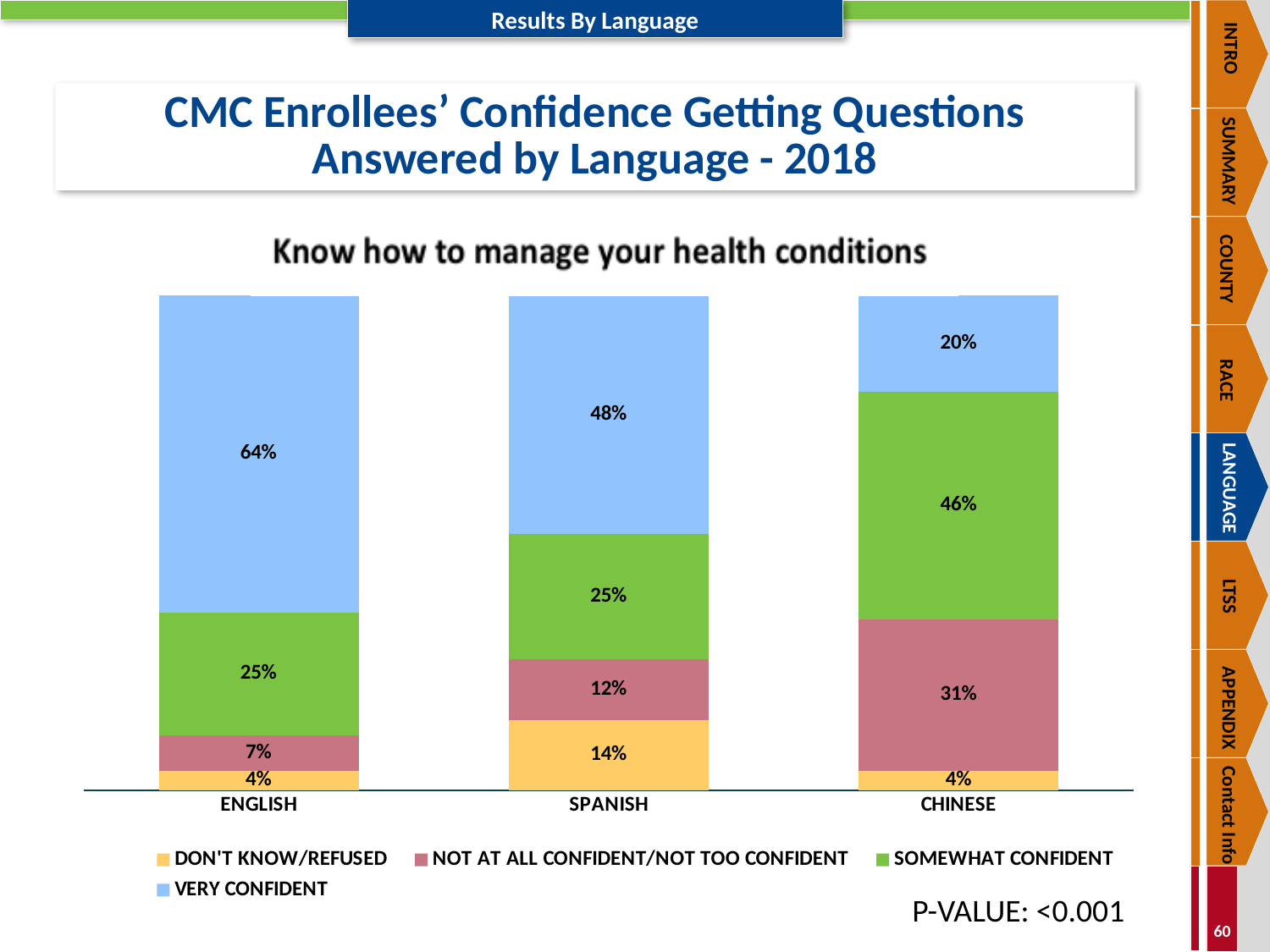
Which language group has the highest share of very confident enrollees? English What percentage of Spanish-speaking enrollees answered don't know/refused? 14% How many series does the legend list? 4 What percentage of English-speaking enrollees were very confident? 64% Which language group has the lowest share of very confident enrollees? Chinese Which is larger: the somewhat confident share for Chinese or for Spanish? Chinese How many language groups are shown on the x axis? 3 What is the difference between the very confident share for English and for Spanish? 16% What percentage of Chinese-speaking enrollees were not at all confident/not too confident? 31% What percentage of Chinese-speaking enrollees were somewhat confident? 46% What is the total of the English stacked bar? 100% What kind of chart is shown on the slide? stacked bar chart